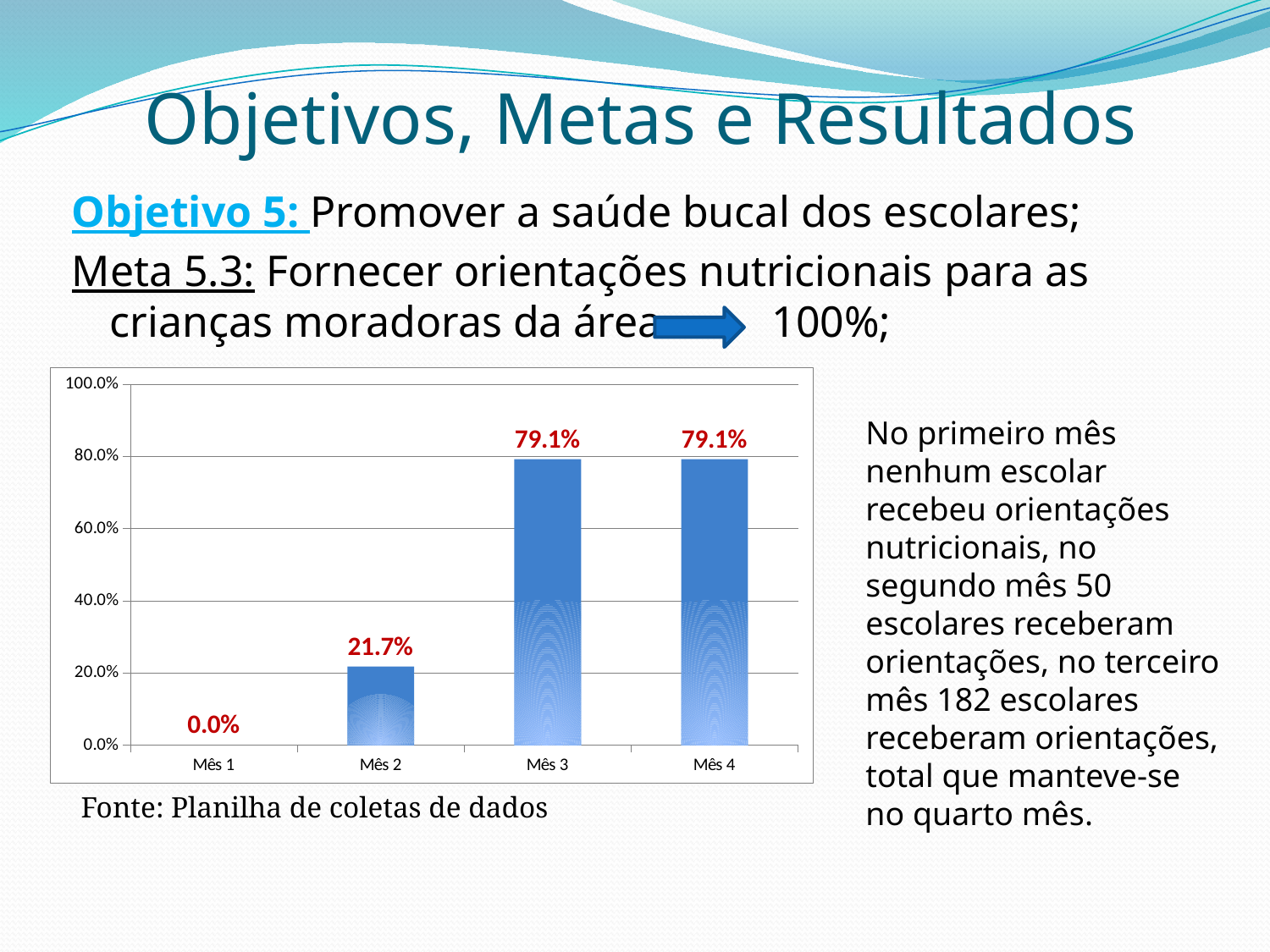
Do the values rise or fall from Mês 1 to Mês 3? rise Is the value for Mês 2 greater or less than 40%? less What is the value for Mês 2? 21.7% Which is larger, the value for Mês 2 or the value for Mês 3? Mês 3 What is the value for Mês 4? 79.1% How many categories are shown on the x axis? 4 What kind of chart is shown on the slide? bar chart What is the maximum value shown on the y axis? 100.0% What is the difference between the values for Mês 3 and Mês 2? 57.4% What is the value for Mês 1? 0.0% Which category has the lowest value? Mês 1 What is the value for Mês 3? 79.1%